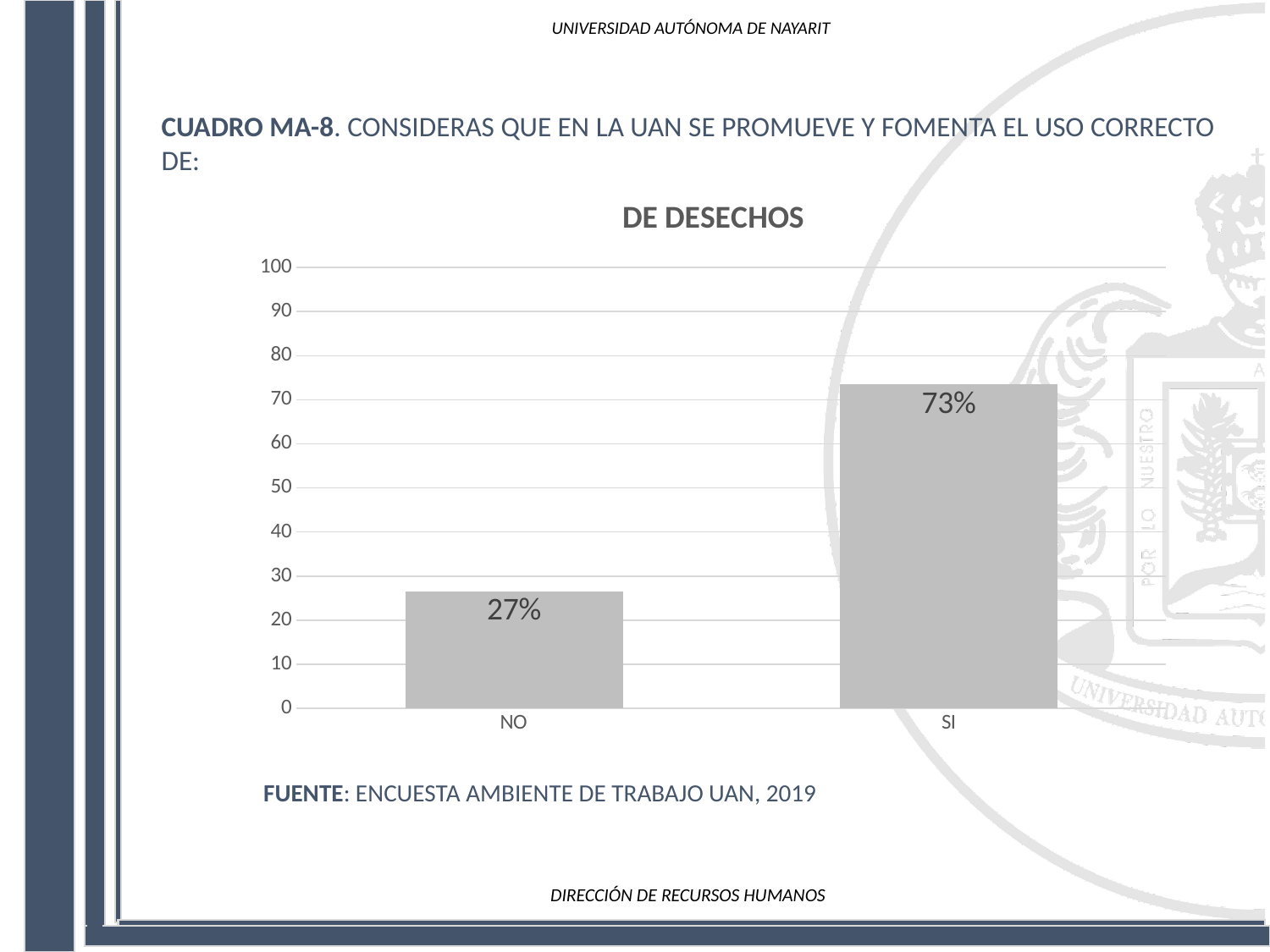
What kind of chart is shown on the slide? bar chart What is the title of the chart? DE DESECHOS What is the value for NO? 27% Is the value for NO greater or less than 30? less Which category has the highest value? SI How many categories are shown in the chart? 2 What is the difference between the values for SI and NO? 46% Which is larger, the value for NO or the value for SI? SI Is the value for SI greater or less than 70? greater Which category has the lowest value? NO What is the source cited below the chart? ENCUESTA AMBIENTE DE TRABAJO UAN, 2019 What is the value for SI? 73%